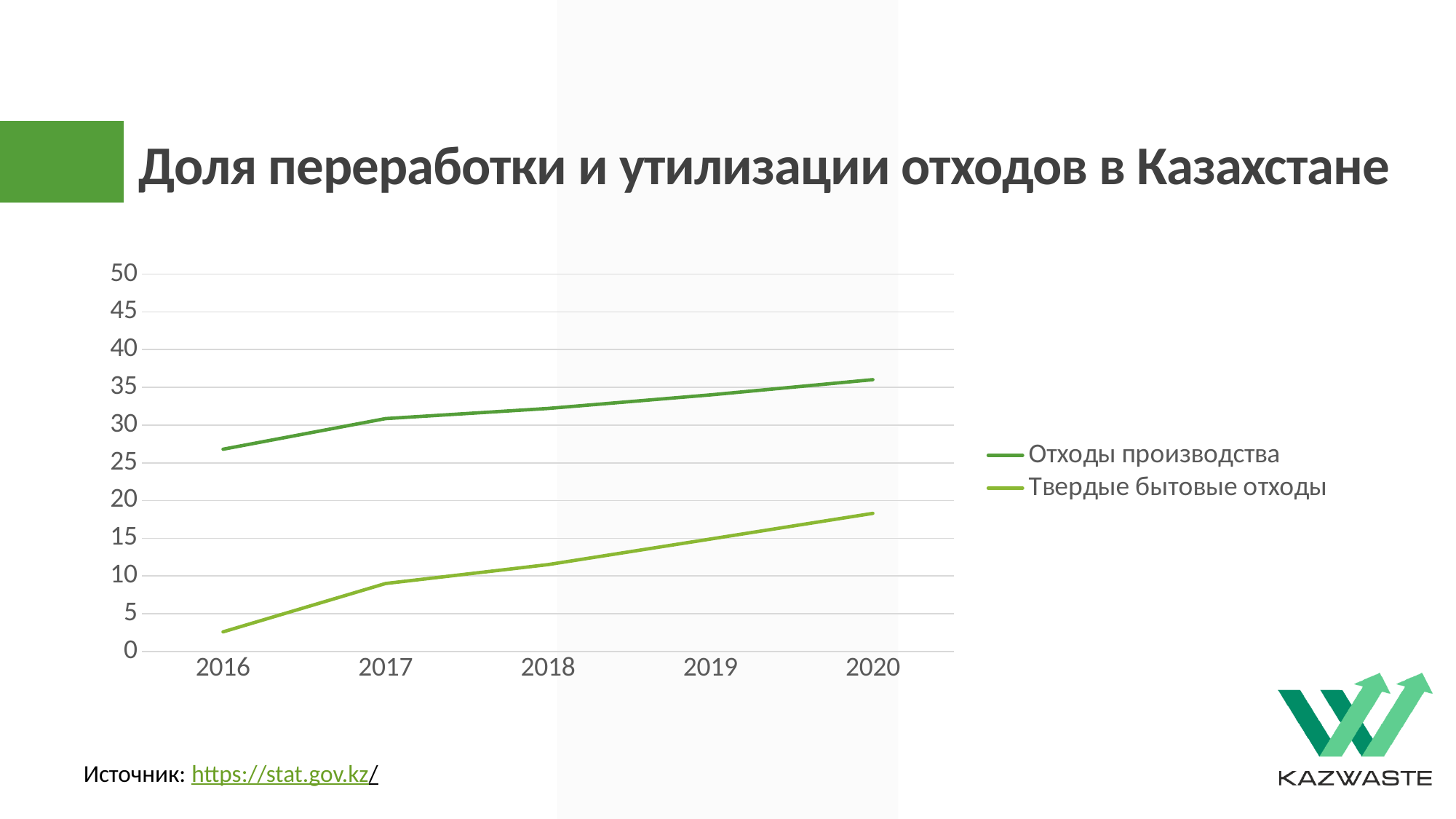
Does the value for Отходы производства rise or fall from 2016 to 2020? rise Which series has the larger value in 2020, Отходы производства or Твердые бытовые отходы? Отходы производства Is the value for Твердые бытовые отходы in 2016 greater or less than 5? less Is the value for Твердые бытовые отходы in 2020 greater or less than 20? less How many series does the legend list? 2 What kind of chart is shown on the slide? line chart Is the value for Отходы производства in 2016 greater or less than 25? greater Does the value for Твердые бытовые отходы rise or fall from 2016 to 2020? rise What is the title of the chart on the slide? Доля переработки и утилизации отходов в Казахстане In which year is the value for Твердые бытовые отходы highest? 2020 In which year is the value for Отходы производства lowest? 2016 How many years are shown on the x axis? 5